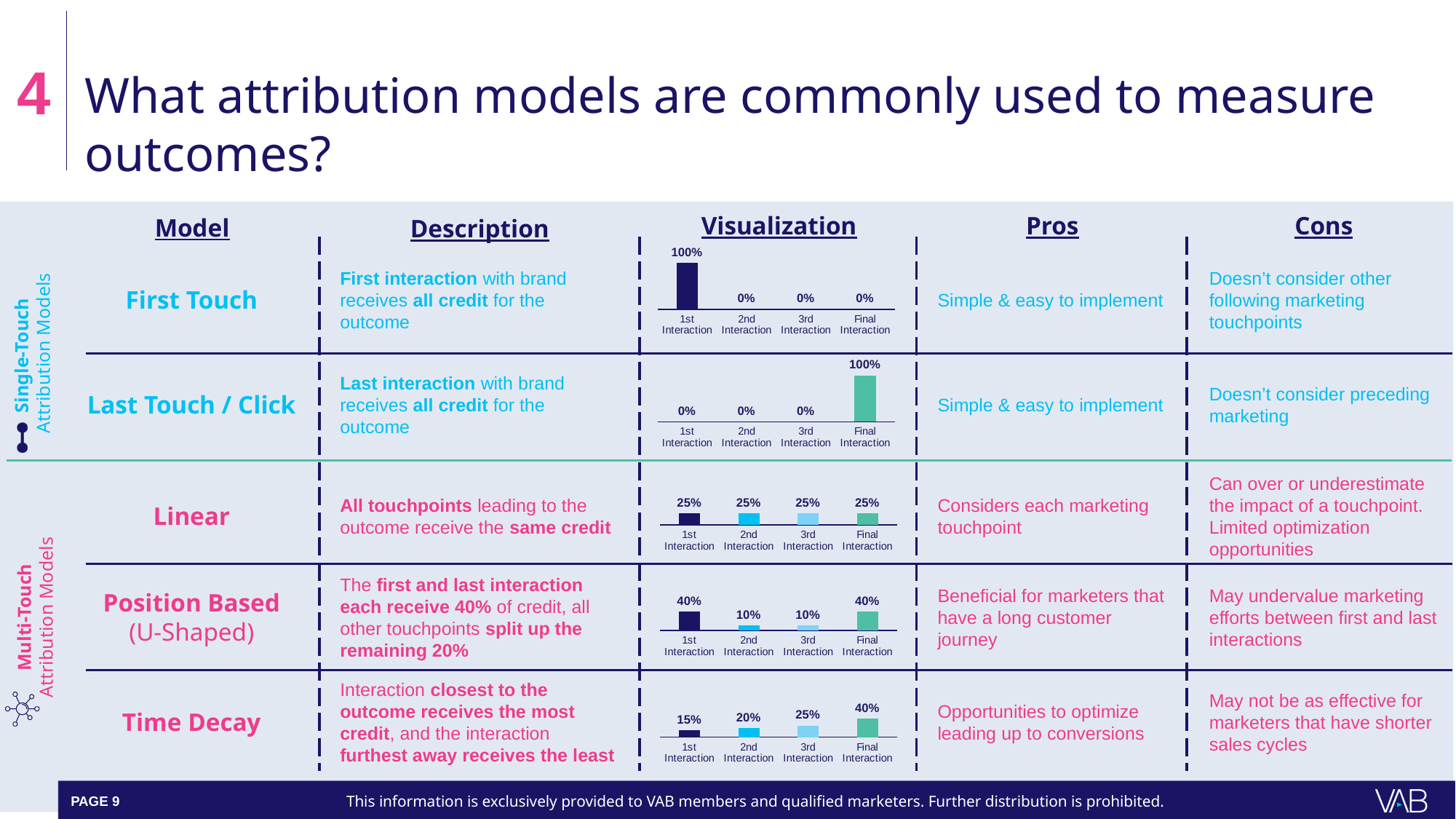
In the Position Based (U-Shaped) visualization chart, what is the difference between the 1st Interaction and 2nd Interaction values? 30% In the Time Decay visualization chart, which is larger, the value for 2nd Interaction or 3rd Interaction? 3rd Interaction In the Time Decay visualization chart, what is the value for Final Interaction? 40% In the Last Touch / Click visualization chart, which interaction has the highest value? Final Interaction In the Linear visualization chart, what is the value for 3rd Interaction? 25% In the Time Decay visualization chart, which interaction has the lowest value? 1st Interaction How many interaction categories are shown in the Linear visualization chart? 4 In the Time Decay visualization chart, do the values rise or fall from 1st Interaction to Final Interaction? rise In the First Touch visualization chart, what is the value for 1st Interaction? 100% In the Last Touch / Click visualization chart, what is the value for 2nd Interaction? 0% In the Position Based (U-Shaped) visualization chart, what is the value for 2nd Interaction? 10% What type of chart is used in the Position Based (U-Shaped) visualization? bar chart